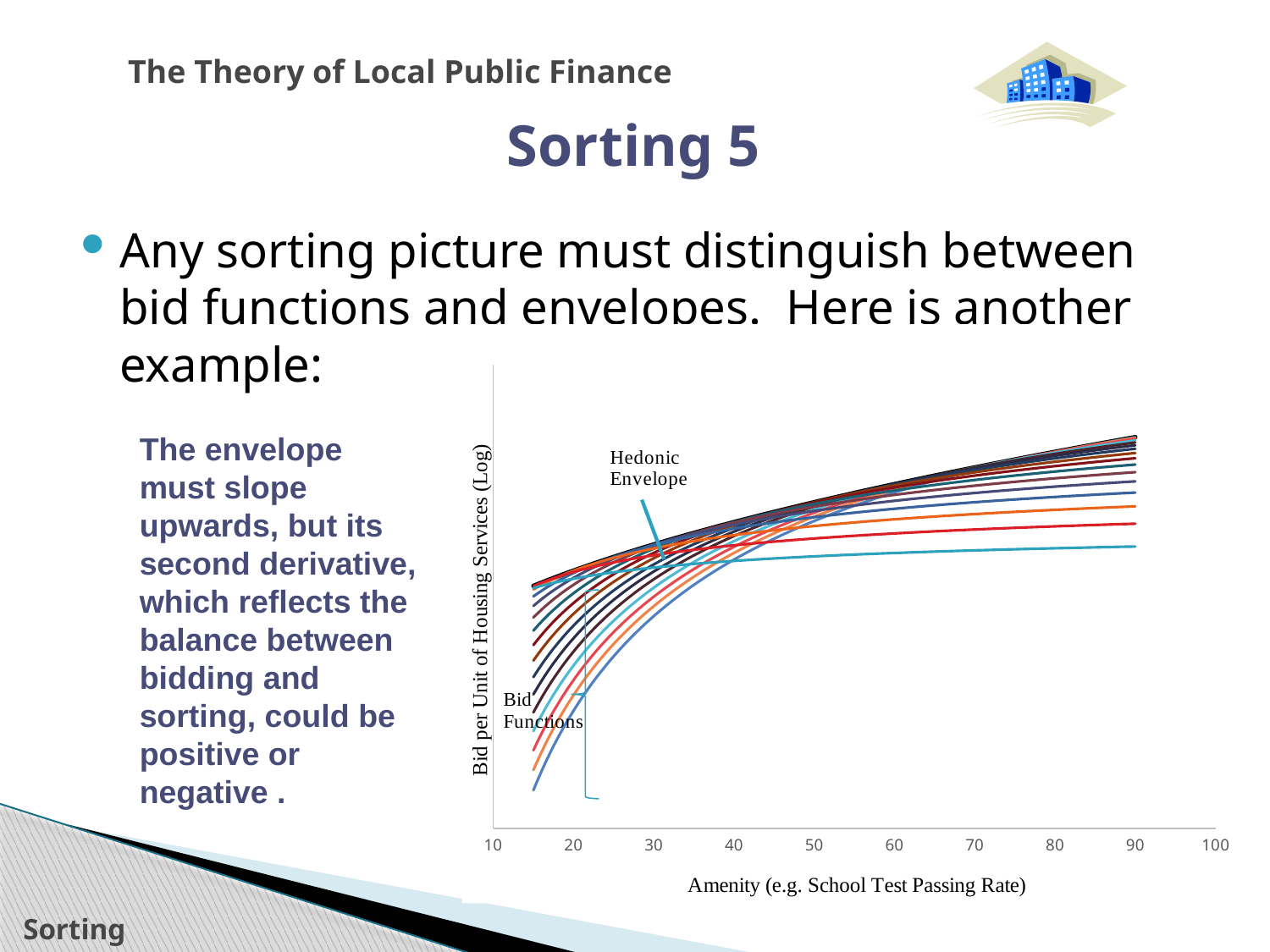
Do the plotted curves rise or fall as the amenity value increases along the x axis? rise Which labelled curve lies above all the bid functions across the chart? Hedonic Envelope What is the title of the x axis of the chart? Amenity (e.g. School Test Passing Rate) What is the title of the y axis of the chart? Bid per Unit of Housing Services (Log) What kind of chart is shown on the slide? line chart